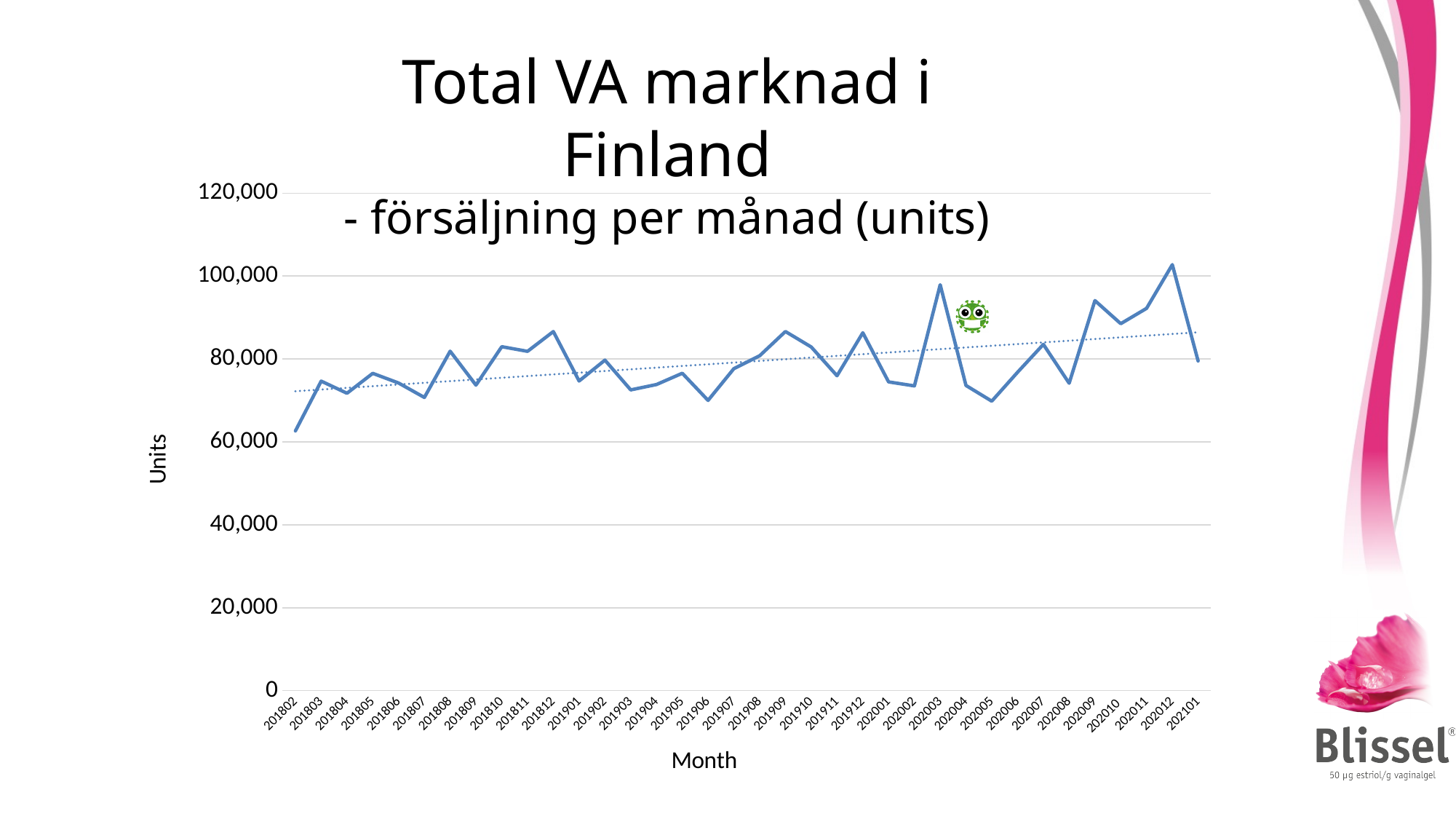
Is the value for 201802 greater or less than 80,000? less Which has the larger value, 202003 or 202005? 202003 Is the value for 202005 greater or less than 80,000? less Does the dotted trend line rise or fall from left to right? rise What is the label of the vertical axis? Units Which month has the lowest value? 201802 Is the value for 202003 greater or less than 80,000? greater Which month has the highest value? 202012 How many months are plotted along the x axis? 36 What kind of chart is shown on the slide? line chart